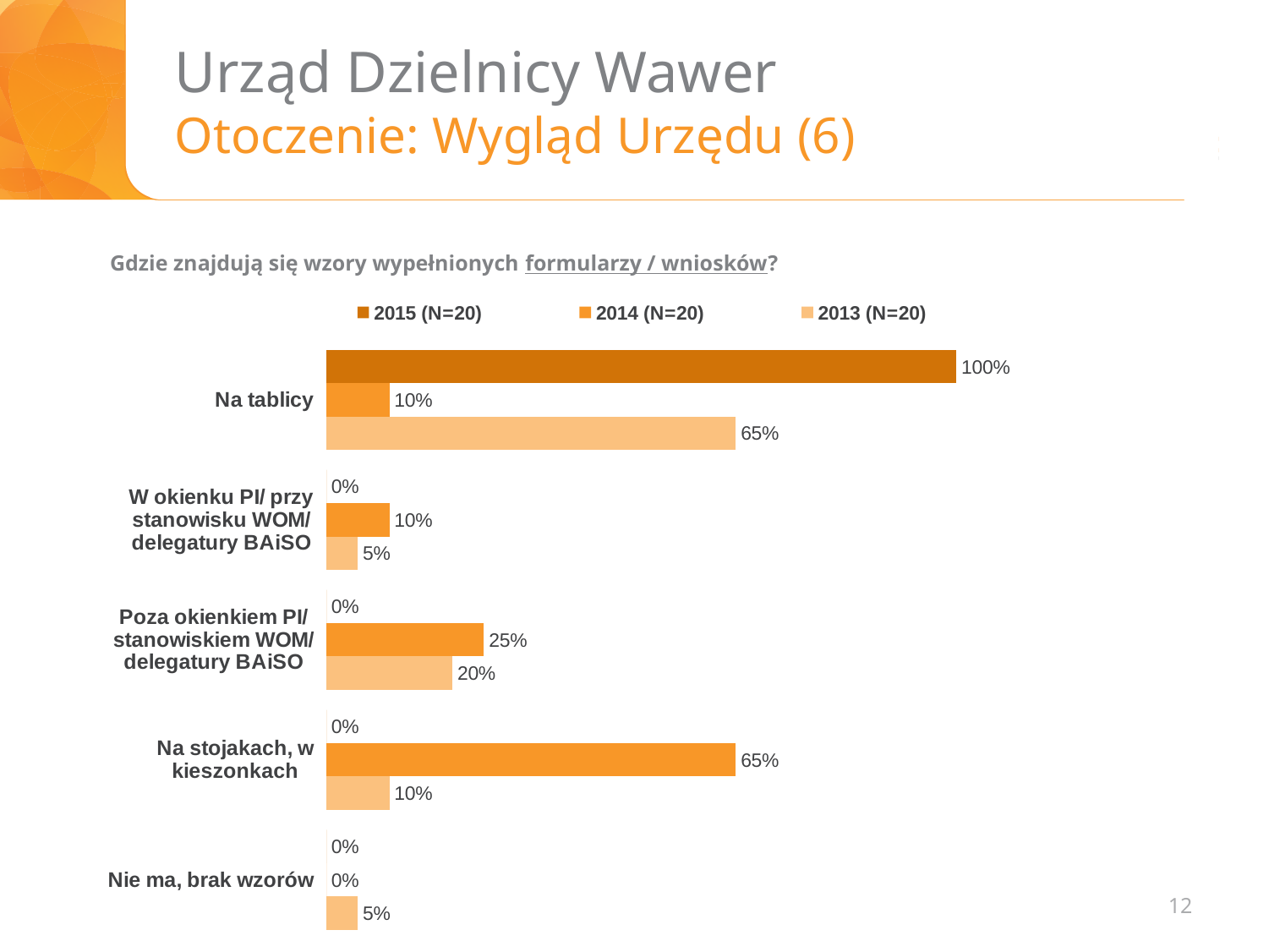
What question does the chart answer, as stated above it? Gdzie znajdują się wzory wypełnionych formularzy / wniosków? Which category has the highest value in the 2013 (N=20) series? Na tablicy What is the difference between the 2015 (N=20) and 2013 (N=20) values for "Na tablicy"? 35% What is the value for "Nie ma, brak wzorów" in the 2013 (N=20) series? 5% What is the value for "Na stojakach, w kieszonkach" in the 2014 (N=20) series? 65% Which category has the highest value in the 2014 (N=20) series? Na stojakach, w kieszonkach For "Poza okienkiem PI/ stanowiskiem WOM/ delegatury BAiSO", which series has the larger value, 2014 (N=20) or 2013 (N=20)? 2014 (N=20) What is the value for "Poza okienkiem PI/ stanowiskiem WOM/ delegatury BAiSO" in the 2013 (N=20) series? 20% What is the value for "Na tablicy" in the 2015 (N=20) series? 100% How many categories are shown on the chart? 5 How many series does the legend list? 3 What kind of chart is shown on the slide? Bar chart